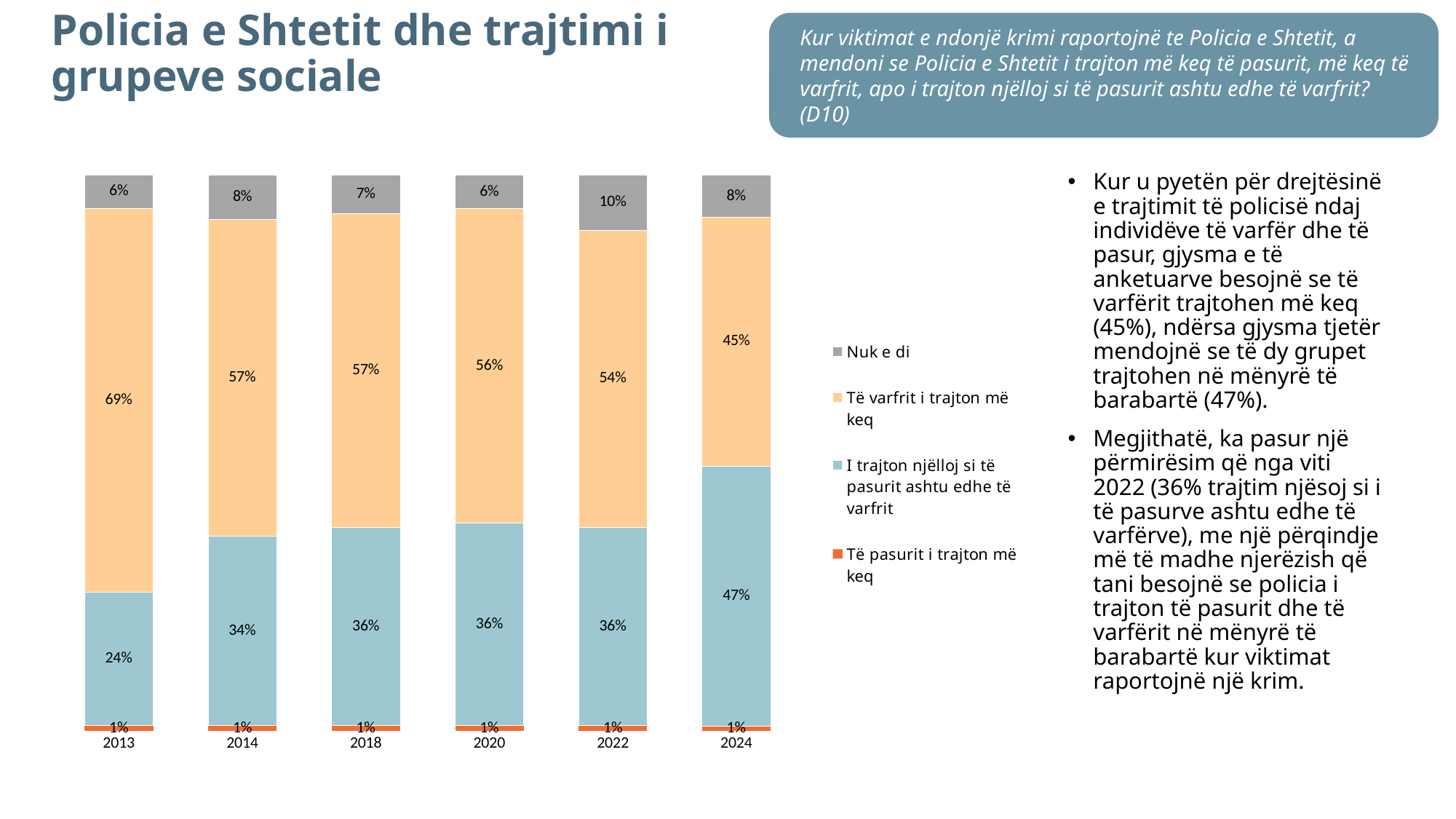
How many years (categories) are shown on the x axis of the chart? 6 What is the value for 'Nuk e di' in 2022? 10% What is the value for 'I trajton njëlloj si të pasurit ashtu edhe të varfrit' in 2024? 47% What is the value for 'Të varfrit i trajton më keq' in 2013? 69% In which year is the 'I trajton njëlloj si të pasurit ashtu edhe të varfrit' value lowest? 2013 Does the 'Të varfrit i trajton më keq' series rise or fall from 2013 to 2024? Fall In 2024, which is larger: 'Të varfrit i trajton më keq' or 'I trajton njëlloj si të pasurit ashtu edhe të varfrit'? I trajton njëlloj si të pasurit ashtu edhe të varfrit How many series does the chart legend list? 4 What type of chart is shown on the slide? Stacked bar chart In which year is the 'Të varfrit i trajton më keq' value highest? 2013 What is the value for 'Të pasurit i trajton më keq' in 2020? 1% What is the difference between the 'Të varfrit i trajton më keq' values in 2013 and 2024? 24%